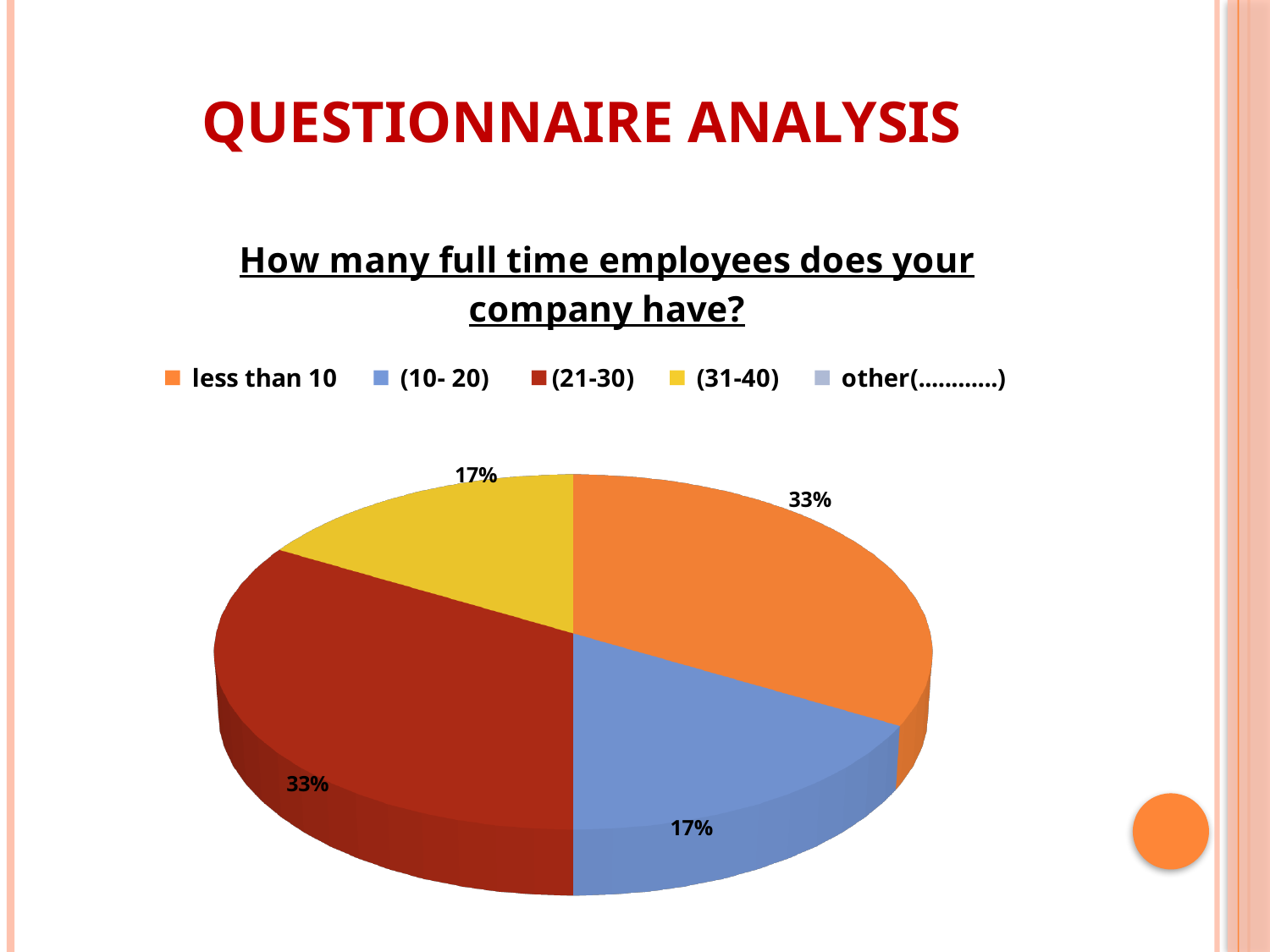
What share of the pie does the "(10- 20)" category have? 17% What is the difference in percentage points between the "(21-30)" share and the "(31-40)" share? 16 percentage points What share of the pie does the "less than 10" category have? 33% What kind of chart is shown on the slide? Pie chart Which is larger, the share for "(21-30)" or the share for "(31-40)"? (21-30) Which is larger, the share for "less than 10" or the share for "(10- 20)"? less than 10 What share of the pie does the "(21-30)" category have? 33% What question is the chart titled with? How many full time employees does your company have? How many slices with data labels are visible in the pie? 4 How many categories does the legend list? 5 What colour is the slice for the "(21-30)" category? Red What share of the pie does the "(31-40)" category have? 17%